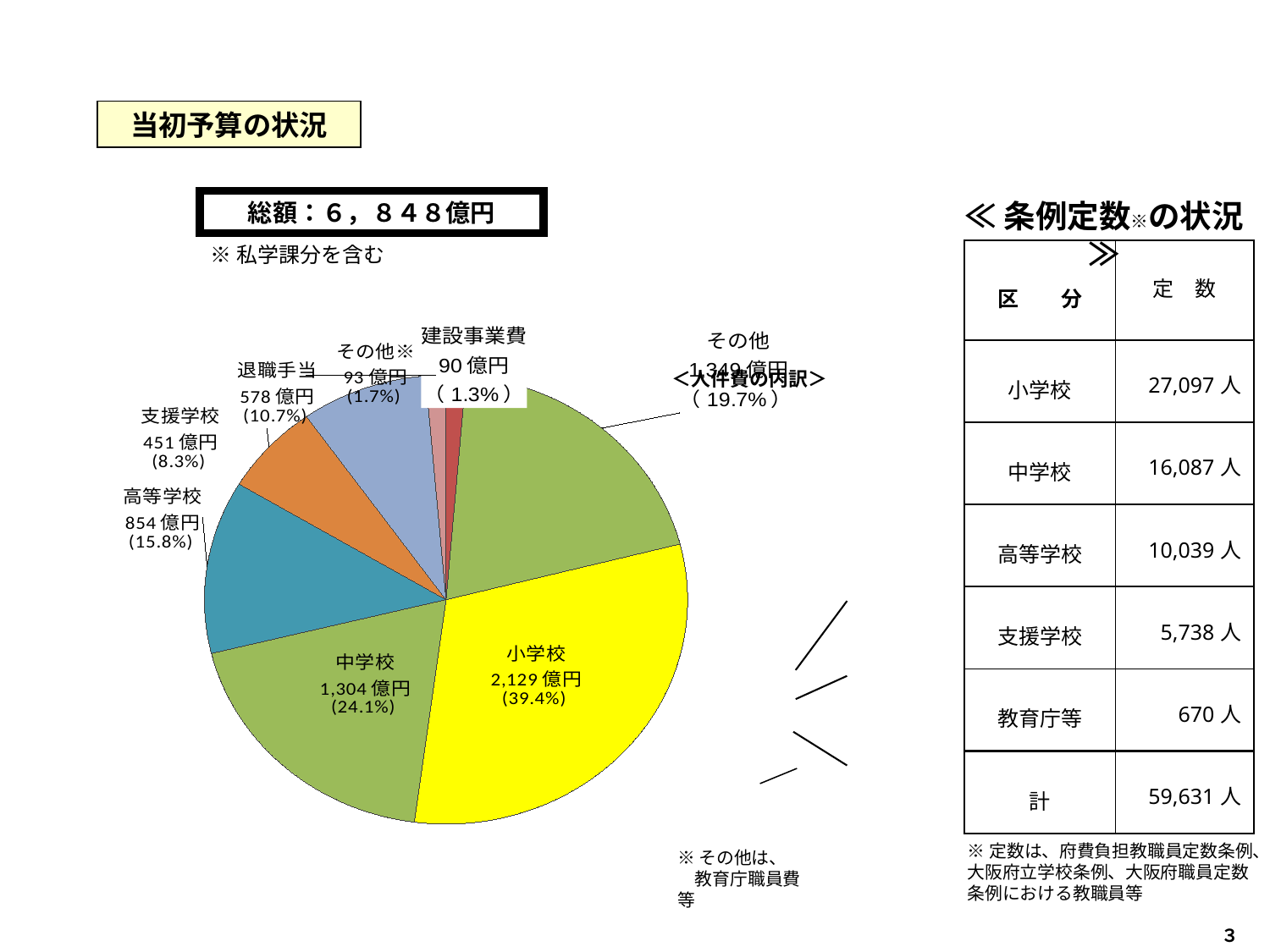
What is the difference between the values for 小学校 and 中学校? 825 億円 Which category has the largest slice in the pie chart? 小学校 What kind of chart is shown on the slide? pie chart What share of the pie does 中学校 represent? 24.1% What is the value for 支援学校 in the pie chart? 451 億円 What is the value for 退職手当 in the pie chart? 578 億円 Which is larger, the value for 高等学校 or the value for 退職手当? 高等学校 What share of the pie does 高等学校 represent? 15.8% What colour is the 小学校 slice in the pie chart? yellow Which category has the smallest slice in the pie chart? 建設事業費 How many slices does the pie chart have? 8 What is the value for 小学校 in the pie chart? 2,129 億円